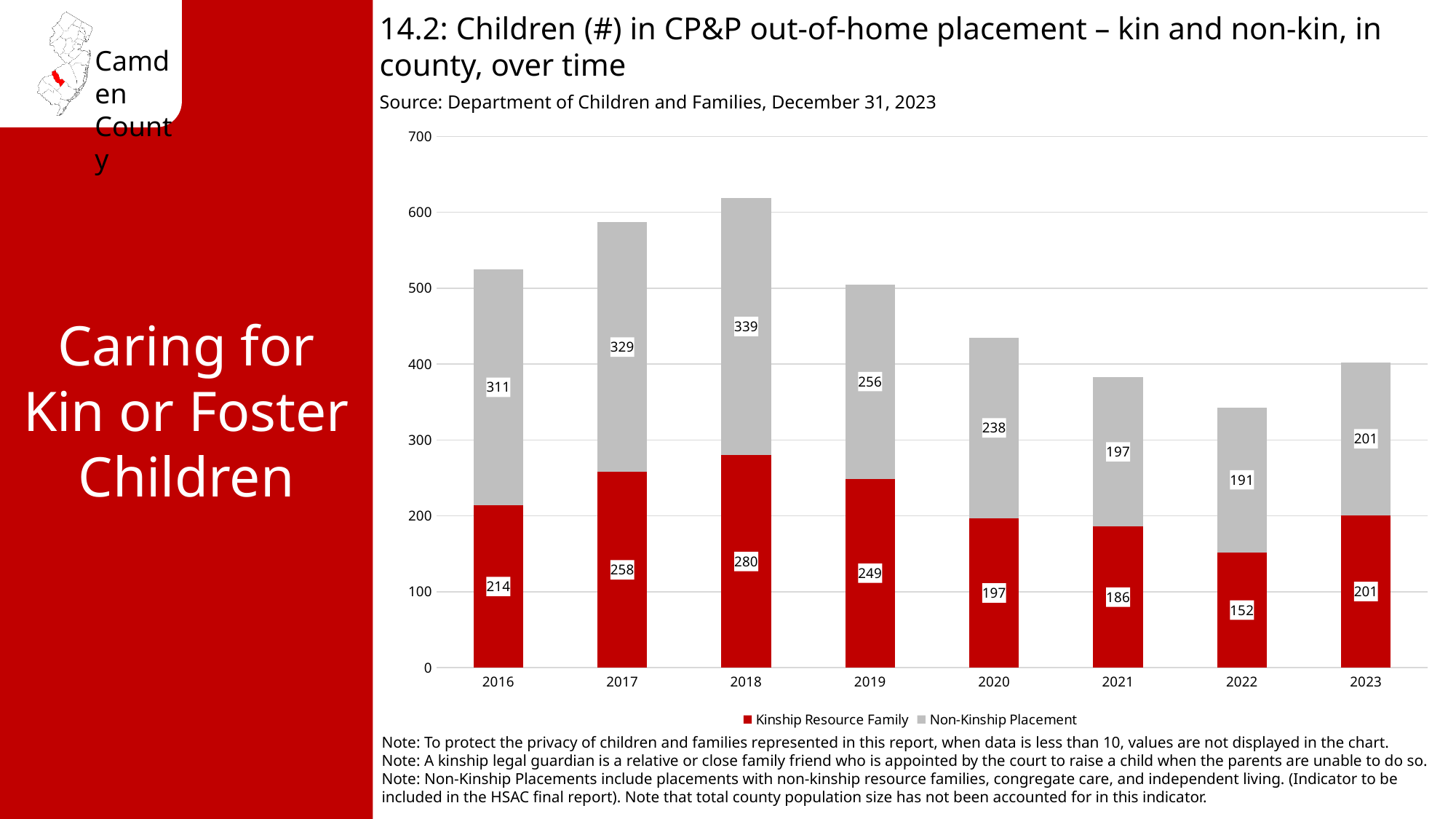
Is the total height of the stacked bar for 2021 greater or less than 400? less How many series does the legend list? 2 What is the difference between the Non-Kinship Placement values for 2017 and 2019? 73 What is the total number of children in out-of-home placement for 2022 (sum of both series)? 343 Which year has the highest Non-Kinship Placement value? 2018 Which is larger, the Kinship Resource Family value for 2020 or for 2023? 2023 How many years are shown on the x axis? 8 Which series is shown in red? Kinship Resource Family Which year has the lowest Kinship Resource Family value? 2022 What is the Kinship Resource Family value for 2018? 280 What kind of chart is shown on the slide? Stacked bar chart What is the Non-Kinship Placement value for 2016? 311